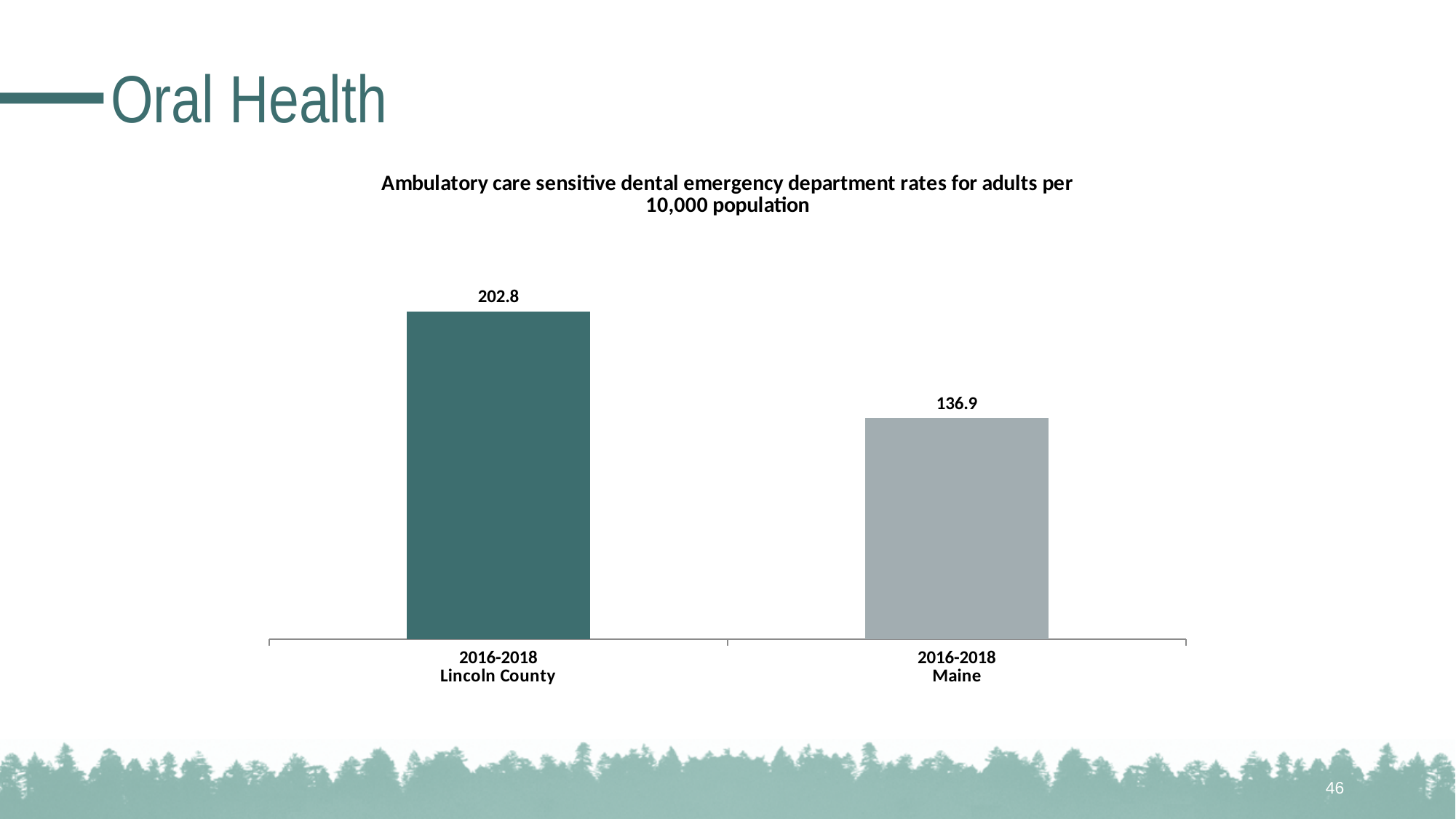
What is the difference between the Lincoln County rate and the Maine rate? 65.9 Which category has the lowest dental emergency department rate? Maine Is the rate for Maine larger or smaller than the rate for Lincoln County? smaller How many bars are shown in the chart? 2 What kind of chart is shown on the slide? bar chart What is the title of the chart? Ambulatory care sensitive dental emergency department rates for adults per 10,000 population What is the ambulatory care sensitive dental emergency department rate for Lincoln County (2016-2018)? 202.8 What time period do the bars in the chart cover? 2016-2018 What is the ambulatory care sensitive dental emergency department rate for Maine (2016-2018)? 136.9 Which category has the higher dental emergency department rate, Lincoln County or Maine? Lincoln County